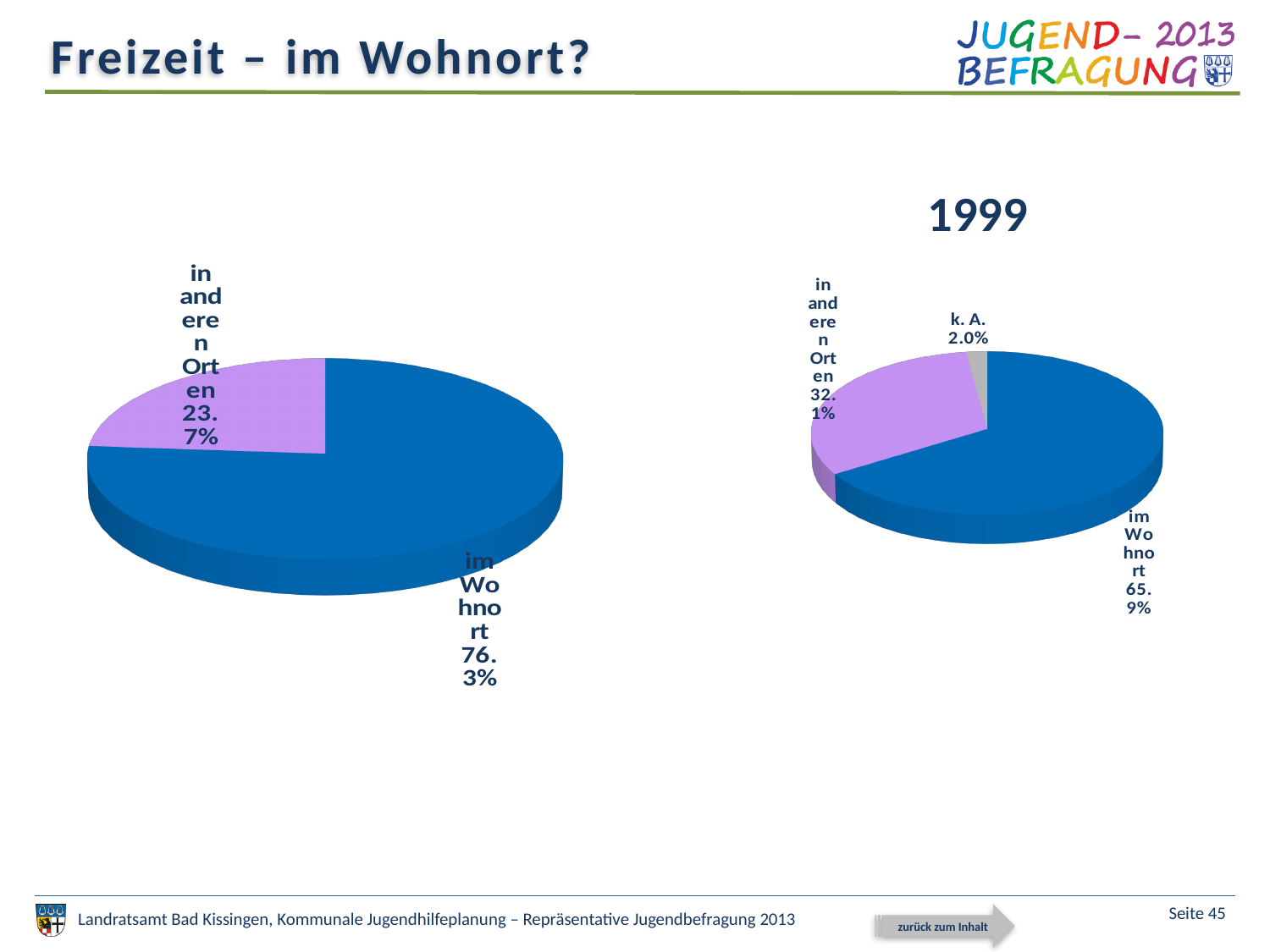
In the pie chart titled "1999", what share is labelled for "k. A."? 2.0% What is the difference between the "im Wohnort" share in the left pie chart and the "im Wohnort" share in the "1999" pie chart? 10.4 percentage points What type of chart is shown on the left of the slide? Pie chart In the left pie chart, what share is labelled for "in anderen Orten"? 23.7% In the left pie chart, which slice is the largest? im Wohnort Which is larger: the "in anderen Orten" share in the left pie chart or in the "1999" pie chart? 1999 In the left pie chart, what share is labelled for "im Wohnort"? 76.3% How many slices does the pie chart titled "1999" have? 3 In the pie chart titled "1999", what share is labelled for "in anderen Orten"? 32.1% In the pie chart titled "1999", which slice is the smallest? k. A. In the pie chart titled "1999", what share is labelled for "im Wohnort"? 65.9% How many slices does the left pie chart have? 2